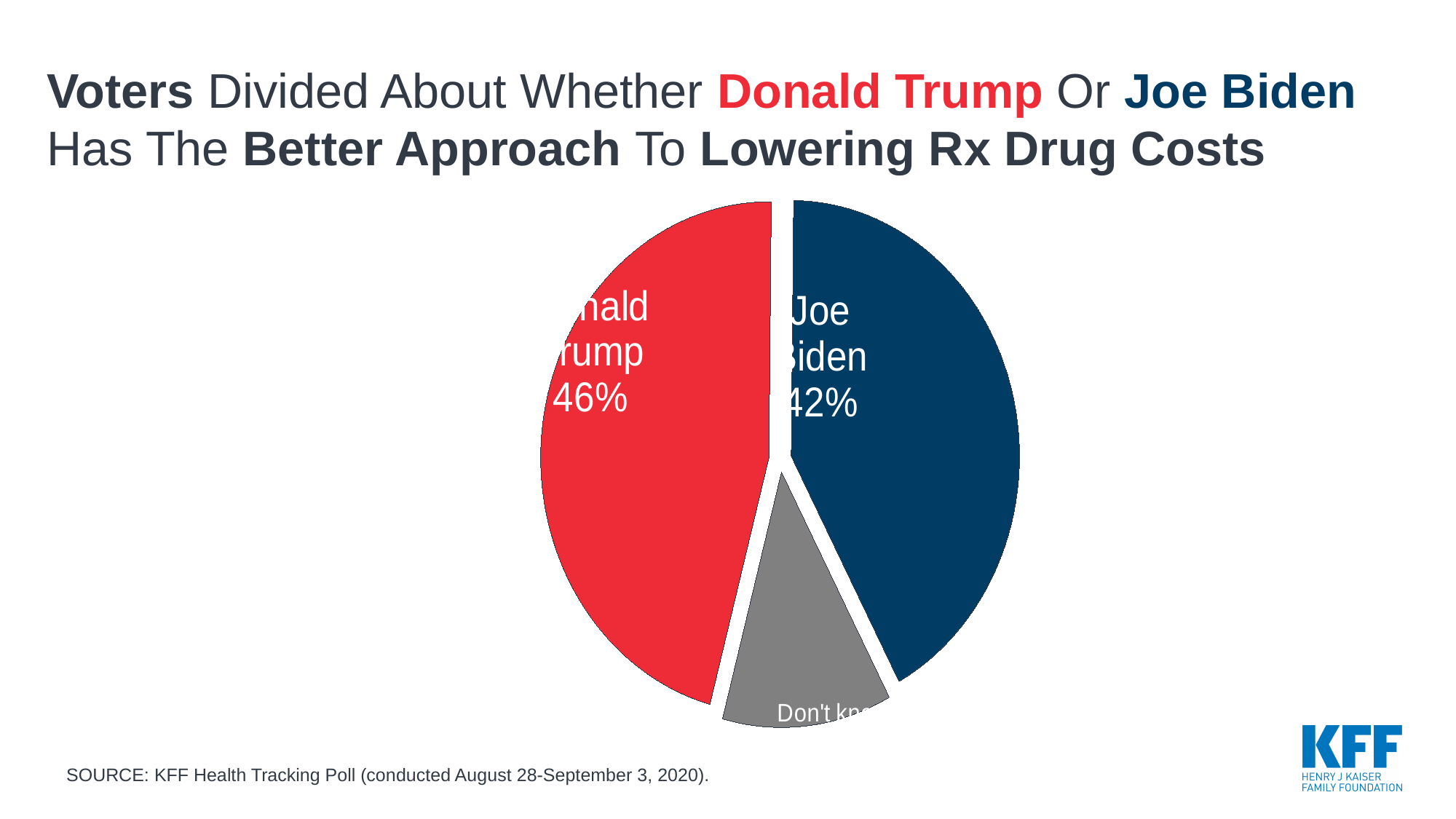
Which is larger, the Joe Biden slice or the Don't know slice? Joe Biden What colour is the Joe Biden slice of the pie chart? dark blue What is the combined share of voters choosing either Donald Trump or Joe Biden? 88% By how many percentage points does the Donald Trump share exceed the Joe Biden share? 4 percentage points What share of voters say Donald Trump has the better approach to lowering Rx drug costs? 46% How many slices does the pie chart have? 3 What share of voters say Joe Biden has the better approach to lowering Rx drug costs? 42% Which is larger, the share for Donald Trump or the share for Joe Biden? Donald Trump Which slice of the pie chart is the smallest? Don't know Which slice of the pie chart is the largest? Donald Trump What colour is the Donald Trump slice of the pie chart? red What kind of chart is shown on the slide? pie chart